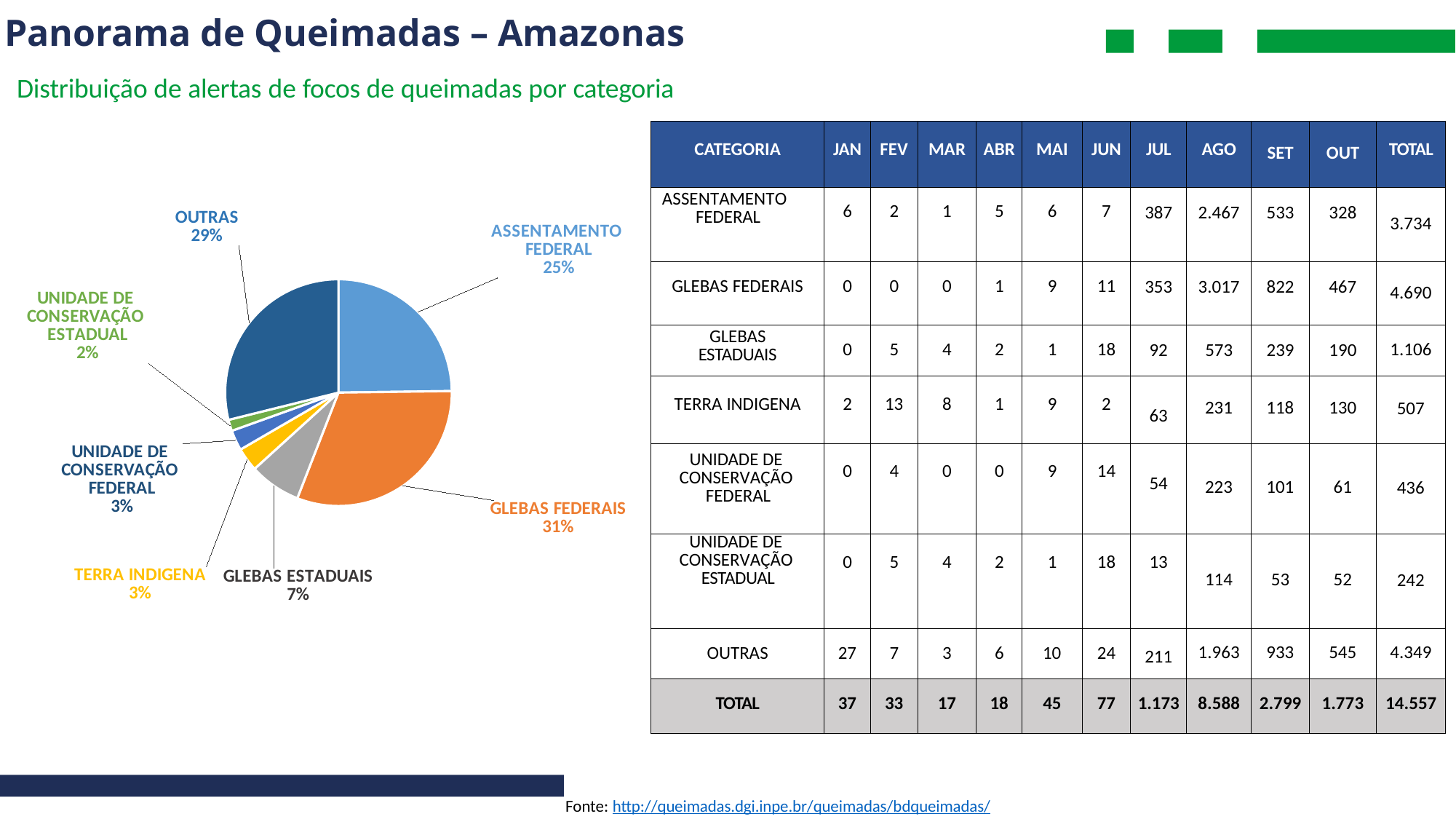
What percentage is shown for TERRA INDIGENA in the pie chart? 3% Which category has the largest slice in the pie chart? GLEBAS FEDERAIS Which slice is larger in the pie chart, OUTRAS or ASSENTAMENTO FEDERAL? OUTRAS What kind of chart is shown on the slide? Pie chart What percentage is shown for ASSENTAMENTO FEDERAL in the pie chart? 25% What share of the pie chart does GLEBAS FEDERAIS represent? 31% How many categories are shown in the pie chart? 7 What colour is the GLEBAS FEDERAIS slice in the pie chart? Orange What percentage is shown for OUTRAS in the pie chart? 29% What share of the pie chart does GLEBAS ESTADUAIS represent? 7% Which category has the smallest slice in the pie chart? UNIDADE DE CONSERVAÇÃO ESTADUAL What is the difference in percentage points between GLEBAS FEDERAIS and OUTRAS in the pie chart? 2 percentage points